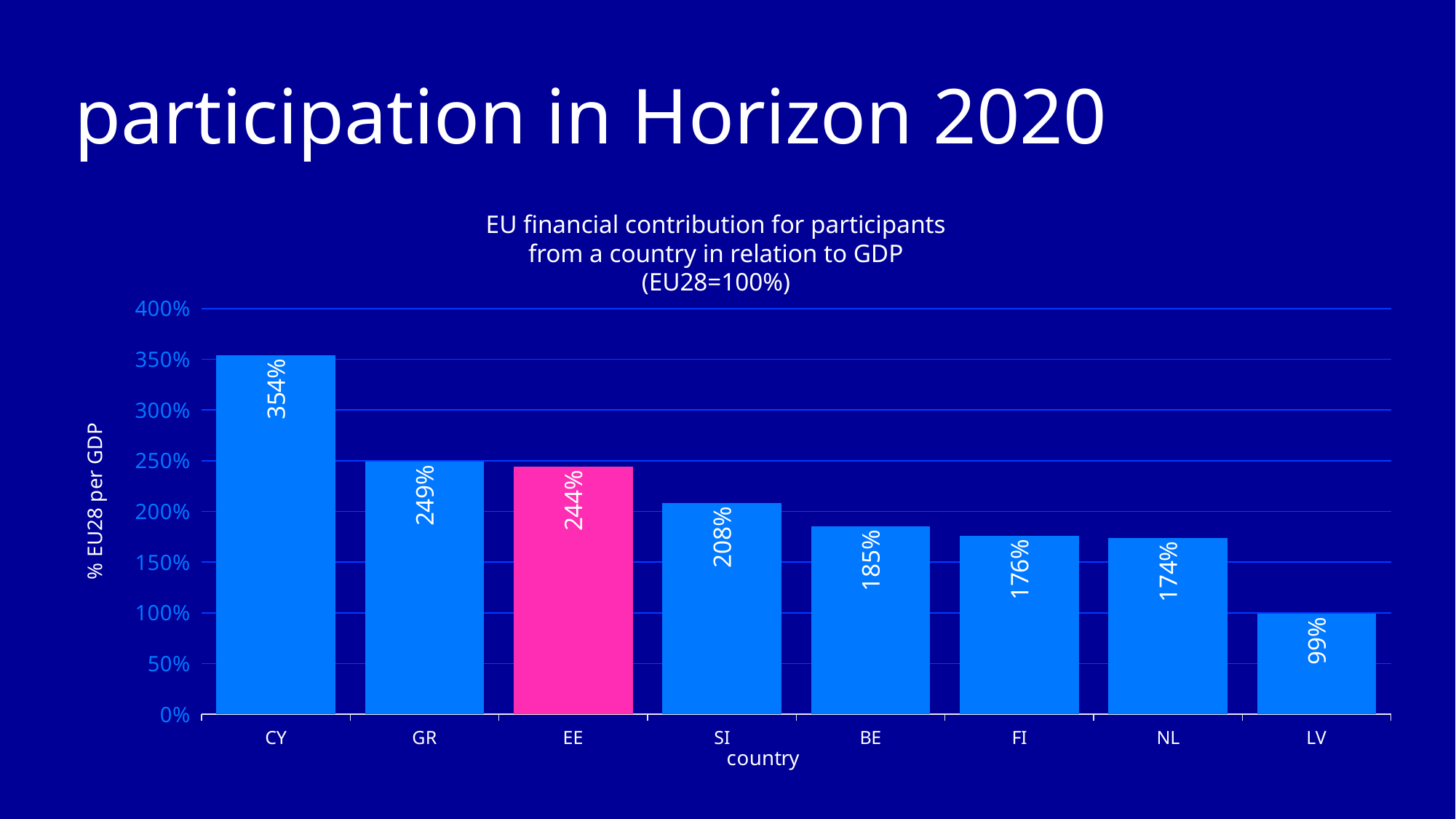
What is the value for CY? 354% What is the value for NL? 174% How many countries are shown on the x axis? 8 Which country has the lowest value? LV What is the value for EE? 244% Is the value for SI greater or less than 150%? greater What is the difference between the values for SI and BE? 23% Which country has the highest value? CY What kind of chart is shown on the slide? bar chart What is the difference between the values for CY and GR? 105% Which is larger, the value for FI or the value for LV? FI Which country's bar is highlighted in pink? EE